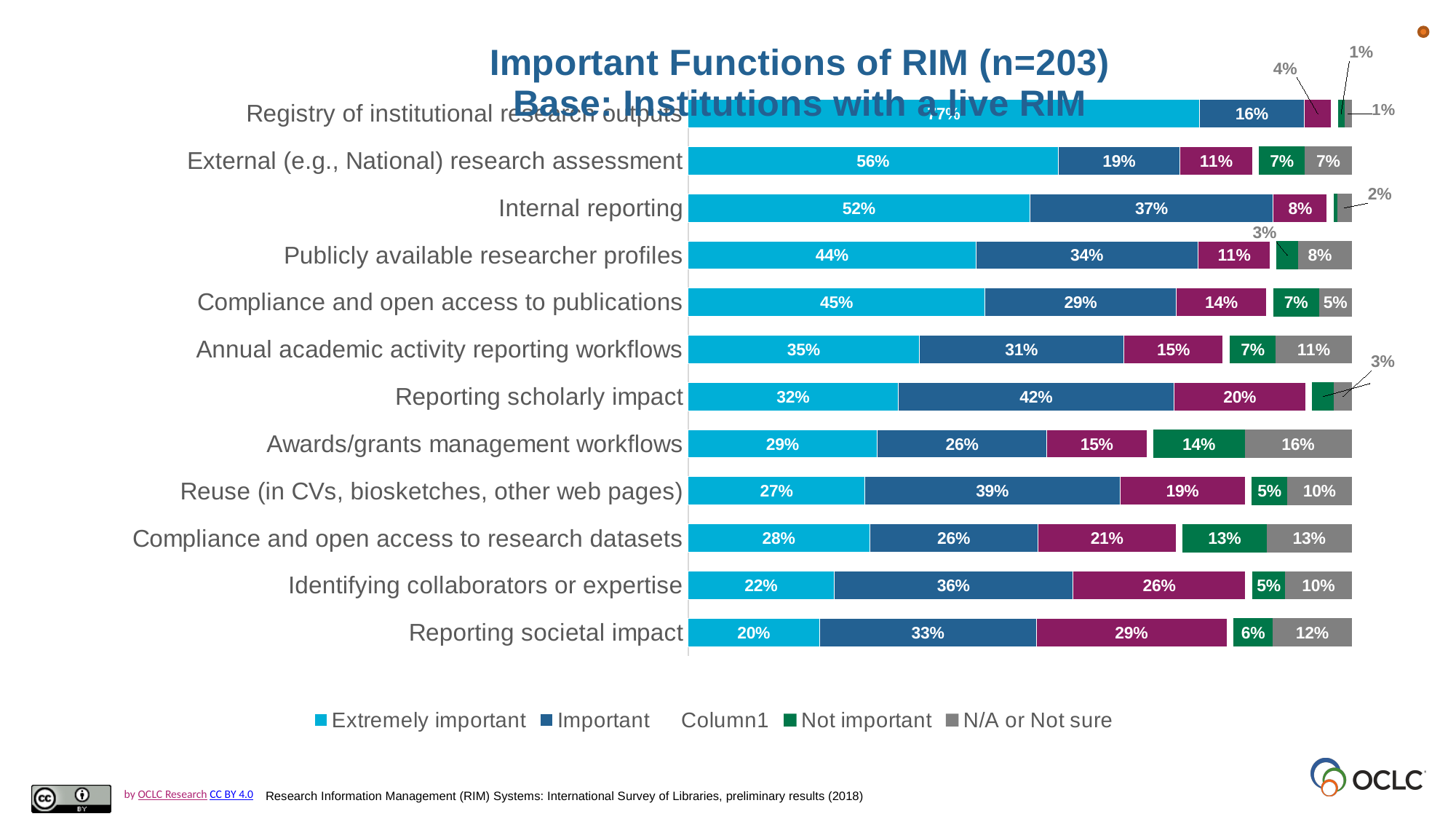
Which function has the smallest Extremely important share? Reporting societal impact What is the Not important value for Identifying collaborators or expertise? 5% How many percentage points higher is the Extremely important value for External (e.g., National) research assessment than for Internal reporting? 4 How many functions (categories) are shown in the chart? 12 Which has a larger Important value: Reporting scholarly impact or Reuse (in CVs, biosketches, other web pages)? Reporting scholarly impact What type of chart is shown on the slide? Stacked bar chart Which function has the largest Extremely important share? Registry of institutional research outputs What percentage of respondents rated Internal reporting as Extremely important? 52% What is the Important value for Reporting societal impact? 33% How many entries does the legend list? 5 Which function has the highest N/A or Not sure share? Awards/grants management workflows What is the N/A or Not sure value for Awards/grants management workflows? 16%